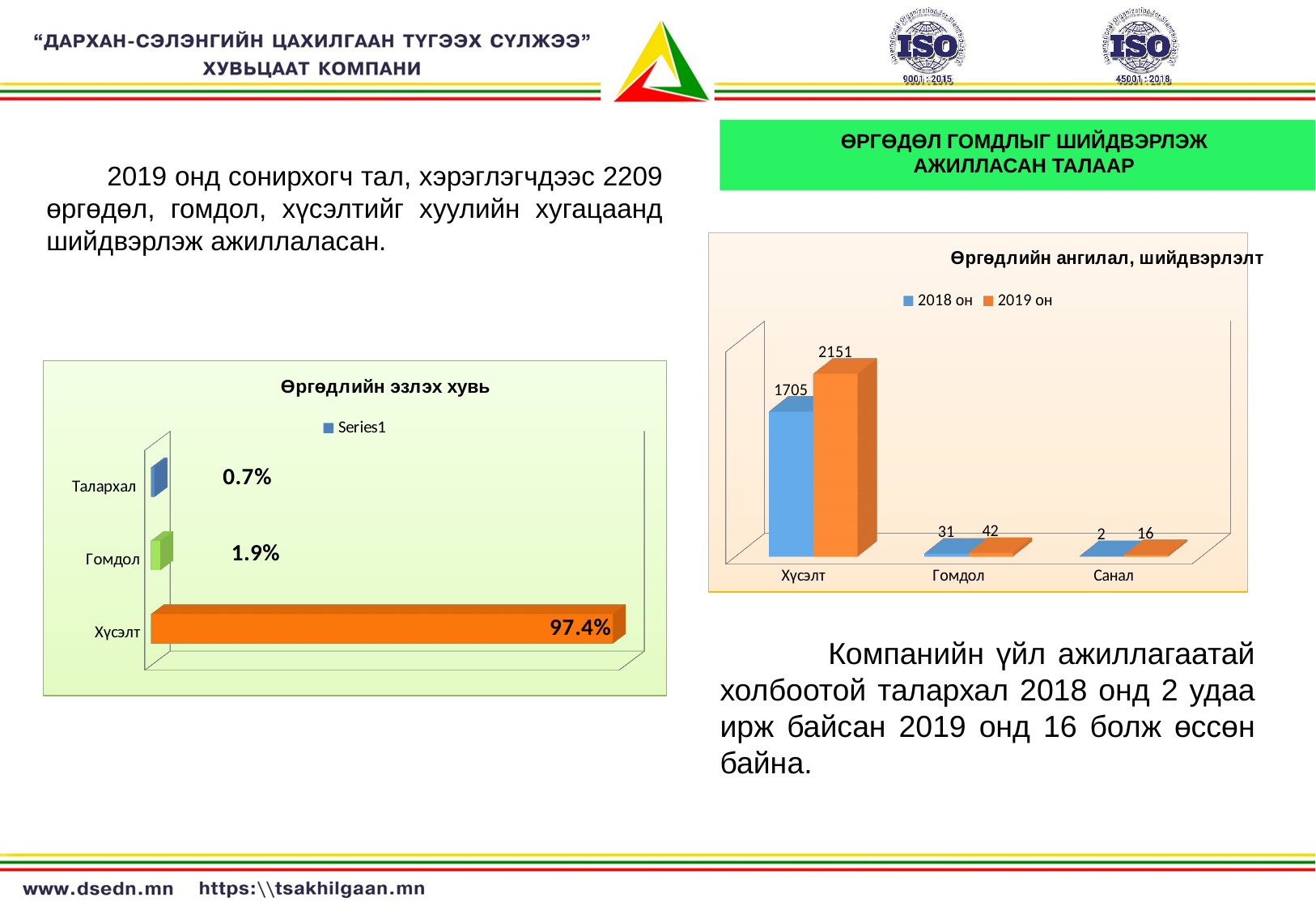
In the chart titled "Өргөдлийн ангилал, шийдвэрлэлт", which is larger for Санал: 2018 он or 2019 он? 2019 он In the chart titled "Өргөдлийн ангилал, шийдвэрлэлт", what colour represents 2019 он? Orange In the chart titled "Өргөдлийн эзлэх хувь", what kind of chart is it? Bar chart In the chart titled "Өргөдлийн эзлэх хувь", how many categories are shown? 3 In the chart titled "Өргөдлийн ангилал, шийдвэрлэлт", what is the value for Хүсэлт in 2019 он? 2151 In the chart titled "Өргөдлийн ангилал, шийдвэрлэлт", how many series does the legend list? 2 In the chart titled "Өргөдлийн эзлэх хувь", which category has the lowest value? Талархал In the chart titled "Өргөдлийн эзлэх хувь", what is the value for Хүсэлт? 97.4% In the chart titled "Өргөдлийн эзлэх хувь", what is the value for Гомдол? 1.9% In the chart titled "Өргөдлийн ангилал, шийдвэрлэлт", what is the difference between the 2019 он and 2018 он values for Хүсэлт? 446 In the chart titled "Өргөдлийн ангилал, шийдвэрлэлт", which category has the highest value in 2018 он? Хүсэлт In the chart titled "Өргөдлийн ангилал, шийдвэрлэлт", what is the value for Гомдол in 2018 он? 31